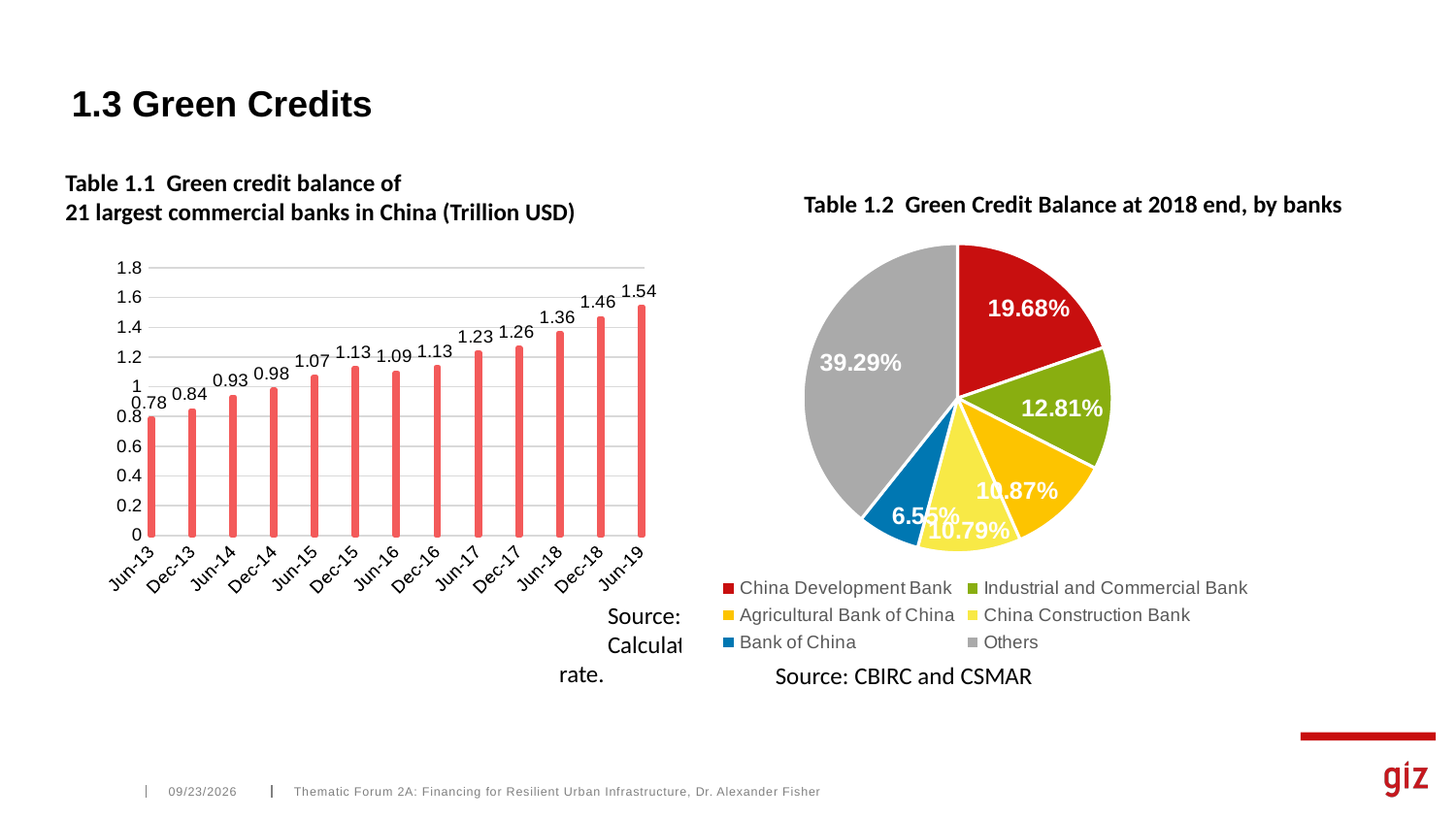
In the pie chart titled 'Table 1.2 Green Credit Balance at 2018 end, by banks', how many entries does the legend list? 6 In the pie chart titled 'Table 1.2 Green Credit Balance at 2018 end, by banks', what colour is the slice for Bank of China? Blue In the chart titled 'Table 1.1 Green credit balance of 21 largest commercial banks in China (Trillion USD)', what is the value for Dec-15? 1.13 In the chart titled 'Table 1.1 Green credit balance of 21 largest commercial banks in China (Trillion USD)', what is the value for Jun-19? 1.54 In the chart titled 'Table 1.1 Green credit balance of 21 largest commercial banks in China (Trillion USD)', which period has the lowest value? Jun-13 In the chart titled 'Table 1.1 Green credit balance of 21 largest commercial banks in China (Trillion USD)', which is larger, the value for Dec-15 or the value for Jun-16? Dec-15 In the pie chart titled 'Table 1.2 Green Credit Balance at 2018 end, by banks', what share does China Development Bank have? 19.68% In the chart titled 'Table 1.1 Green credit balance of 21 largest commercial banks in China (Trillion USD)', how many periods are plotted? 13 In the chart titled 'Table 1.1 Green credit balance of 21 largest commercial banks in China (Trillion USD)', do the values generally rise or fall from Jun-13 to Jun-19? Rise In the pie chart titled 'Table 1.2 Green Credit Balance at 2018 end, by banks', which bank category has the largest slice? Others What kind of chart is 'Table 1.1 Green credit balance of 21 largest commercial banks in China (Trillion USD)'? Bar chart In the chart titled 'Table 1.1 Green credit balance of 21 largest commercial banks in China (Trillion USD)', what is the difference between the values for Jun-19 and Jun-13? 0.76